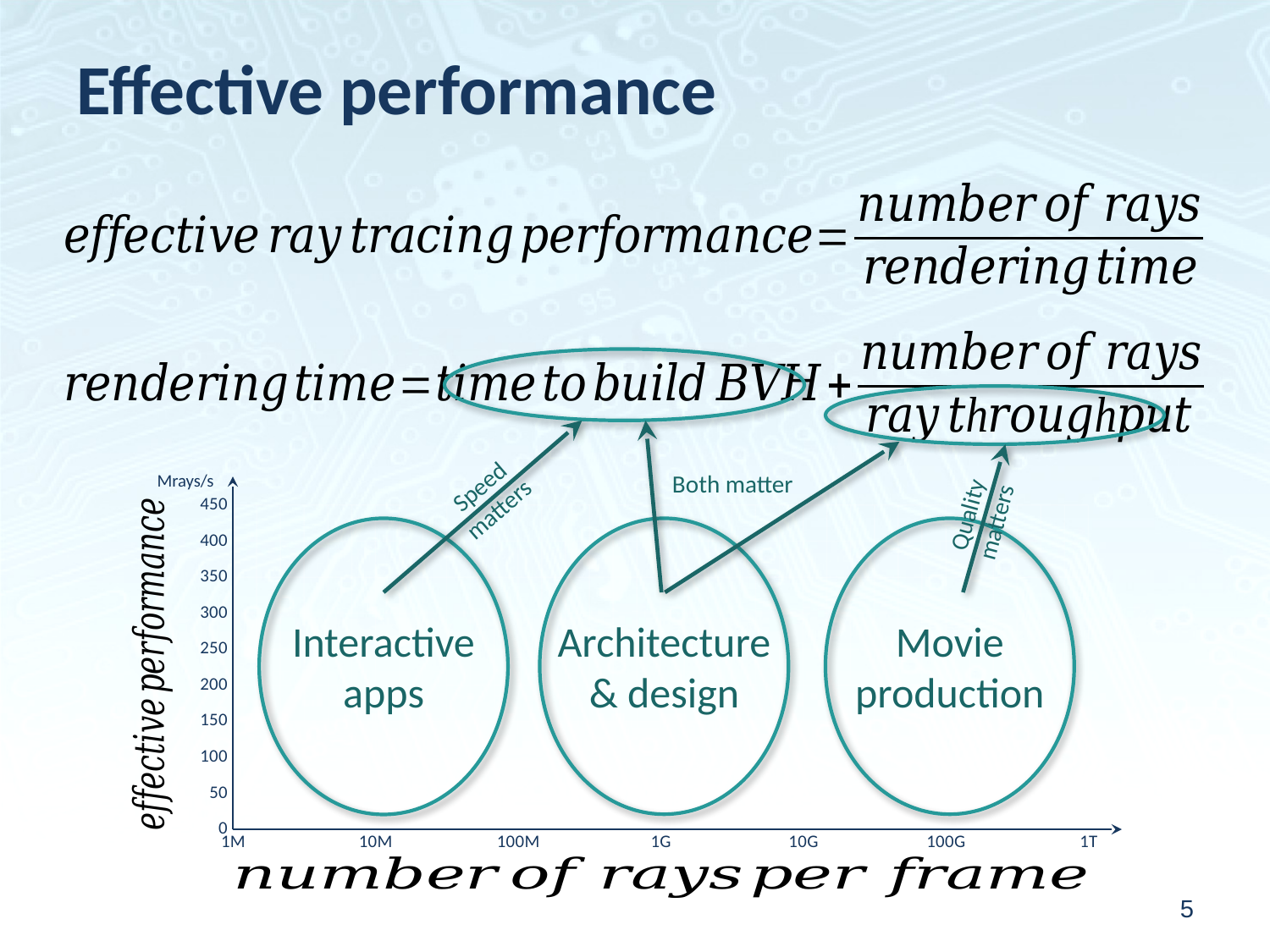
Which application region on the chart is placed at the highest number of rays per frame? Movie production Which application region on the chart is annotated with 'Quality matters'? Movie production What is the highest tick value shown on the y axis of the chart? 450 What is the label on the x axis of the chart? number of rays per frame What is the rightmost tick label on the x axis of the chart? 1T How many labelled application regions (ovals) are drawn on the chart? 3 Which application region on the chart is placed at the lowest number of rays per frame? Interactive apps What is the label on the y axis of the chart? effective performance What is the leftmost tick label on the x axis of the chart? 1M Which application region on the chart is annotated with 'Speed matters'? Interactive apps Which application region on the chart is annotated with 'Both matter'? Architecture & design What unit is shown at the top of the y axis of the chart? Mrays/s